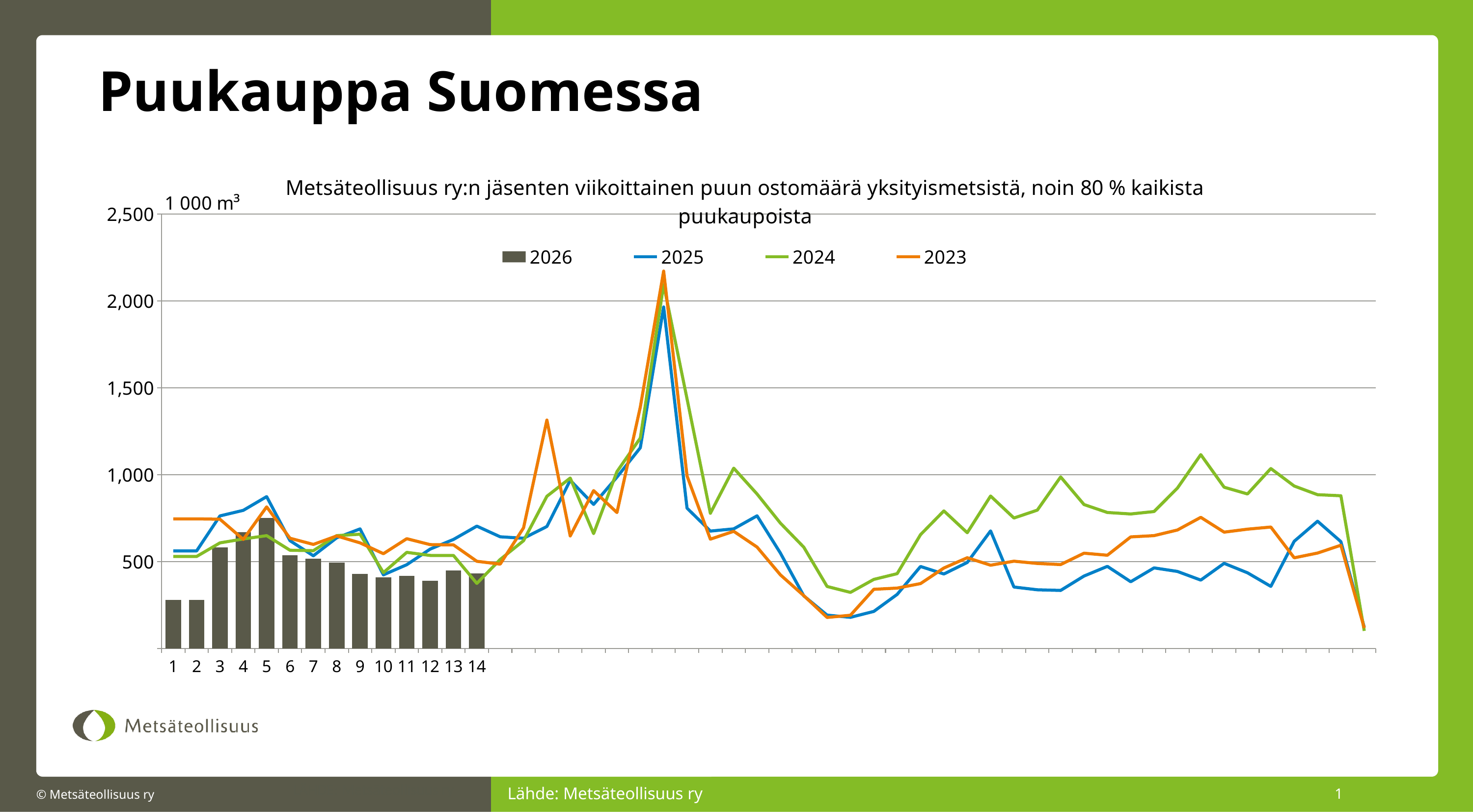
Is the 2026 bar for week 5 greater or less than 500? greater What unit is shown on the vertical axis of the chart? 1 000 m³ What kind of chart is shown on the slide? A combined bar and line chart Is the 2026 bar for week 10 greater or less than 500? less Which is larger, the 2026 bar for week 3 or the 2026 bar for week 10? Week 3 Do the 2026 bars rise or fall from week 5 to week 12? fall How many bars are plotted for the 2026 series? 14 Is the 2026 bar for week 1 greater or less than 500? less How many series does the chart legend list? 4 Which series reaches the highest peak value on the chart? 2023 Which week has the highest 2026 bar? Week 5